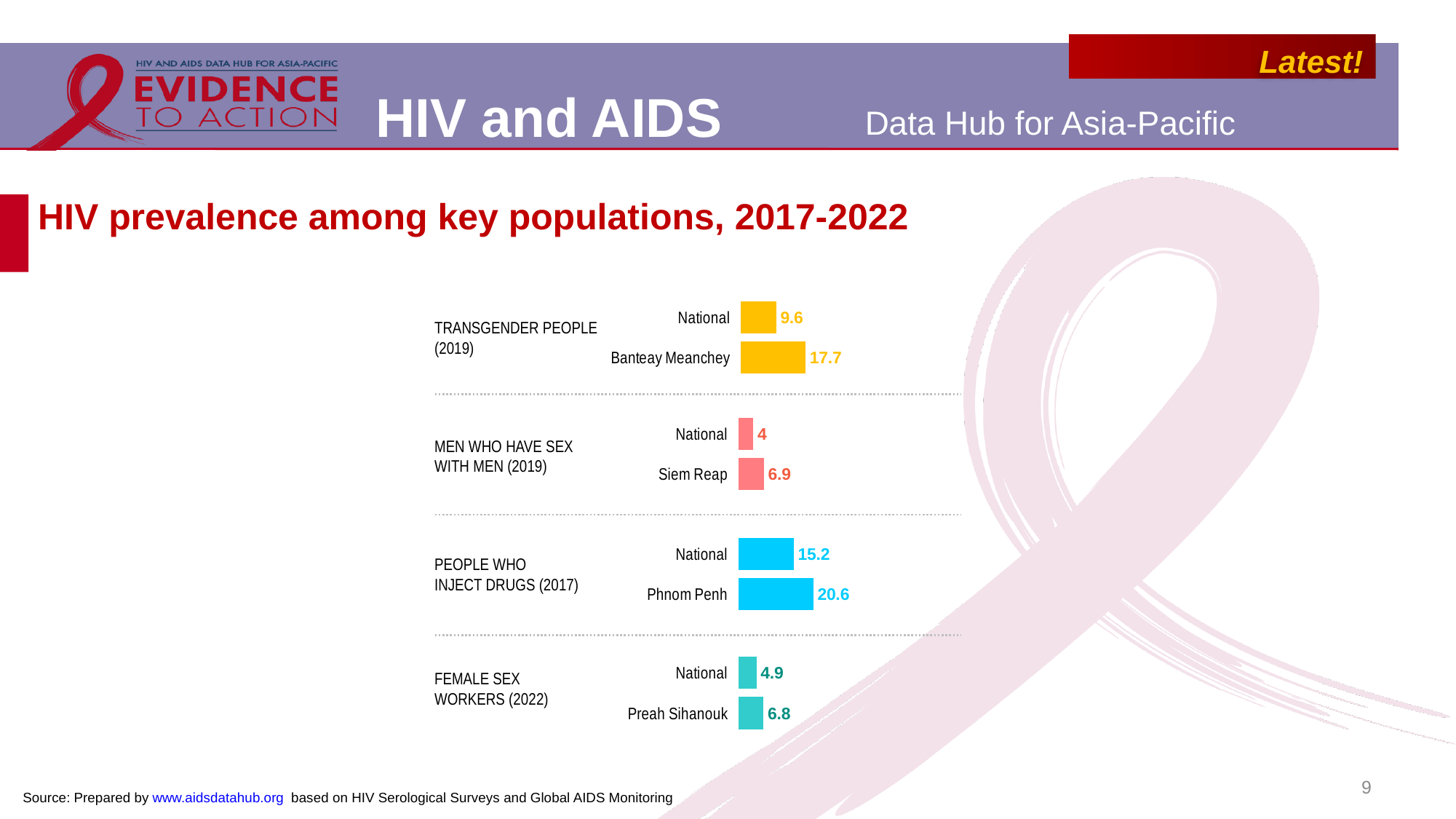
What is the difference between the Banteay Meanchey and national values for transgender people? 8.1 What is the HIV prevalence among people who inject drugs in Phnom Penh? 20.6 What is the difference between the Phnom Penh and national values for people who inject drugs? 5.4 What is the HIV prevalence among men who have sex with men in Siem Reap? 6.9 Which bar shows the lowest HIV prevalence value on the chart? National (men who have sex with men) Which bar shows the highest HIV prevalence value on the chart? Phnom Penh (people who inject drugs) Which is larger: the national value for people who inject drugs or the national value for transgender people? People who inject drugs (15.2) What type of chart is used on this slide? Bar chart What is the HIV prevalence among transgender people in Banteay Meanchey? 17.7 How many key population groups are shown on the chart? 4 What is the national HIV prevalence among female sex workers (2022)? 4.9 What is the national HIV prevalence among transgender people (2019)? 9.6